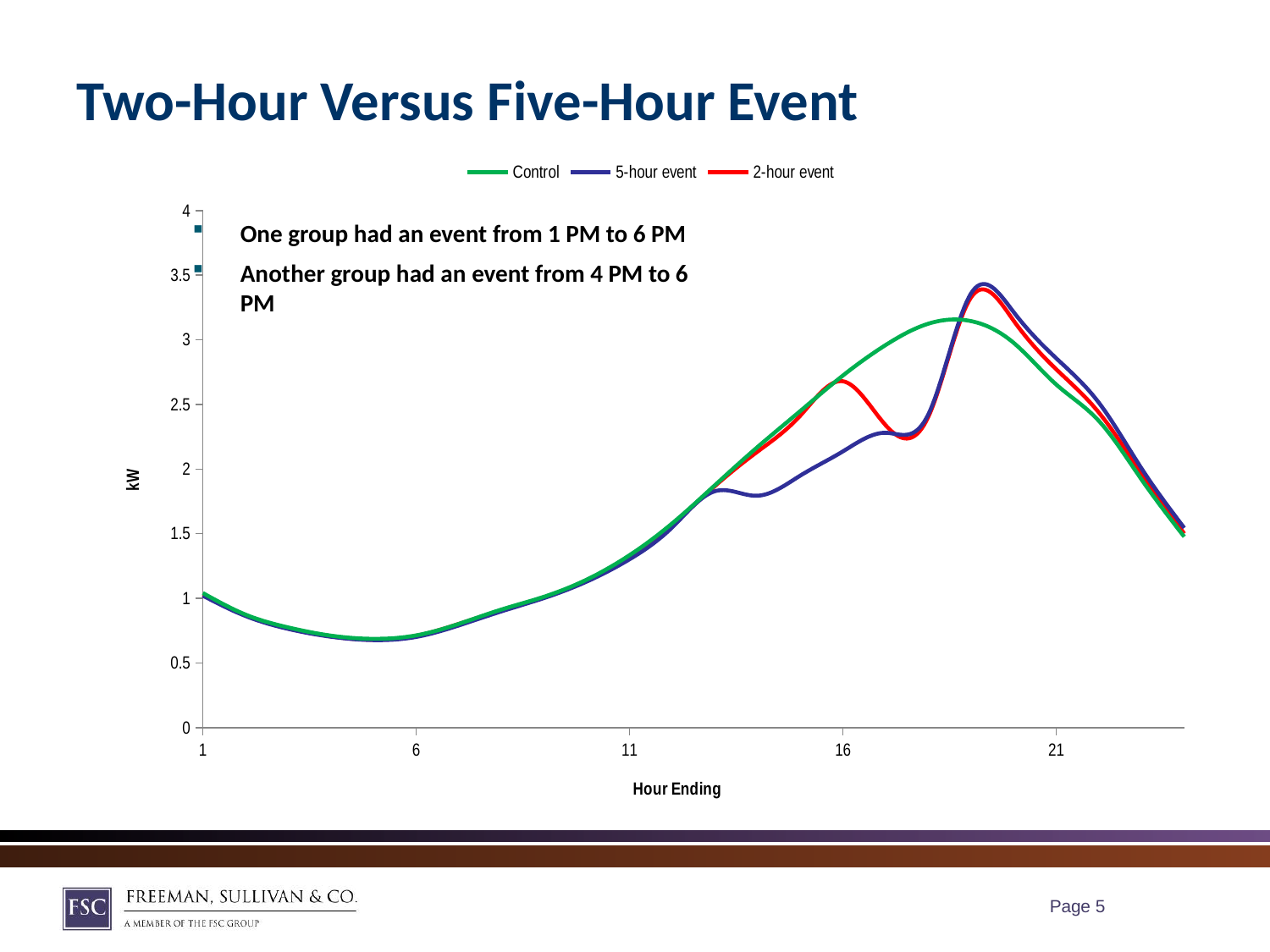
Is the value of the Control line at hour ending 16 greater or less than 2.5? greater Is the peak value of the 5-hour event line greater or less than 3? greater At hour ending 16, which is larger: the Control line or the 5-hour event line? Control Is the peak value of the Control line greater or less than 3.5? less What kind of chart is shown on the slide? line chart How many series does the legend list? 3 Does the Control line rise or fall between hour ending 1 and hour ending 5? fall What are the three series named in the legend? Control, 5-hour event, 2-hour event Which line reaches a higher peak: Control or 5-hour event? 5-hour event What is the label on the vertical axis? kW